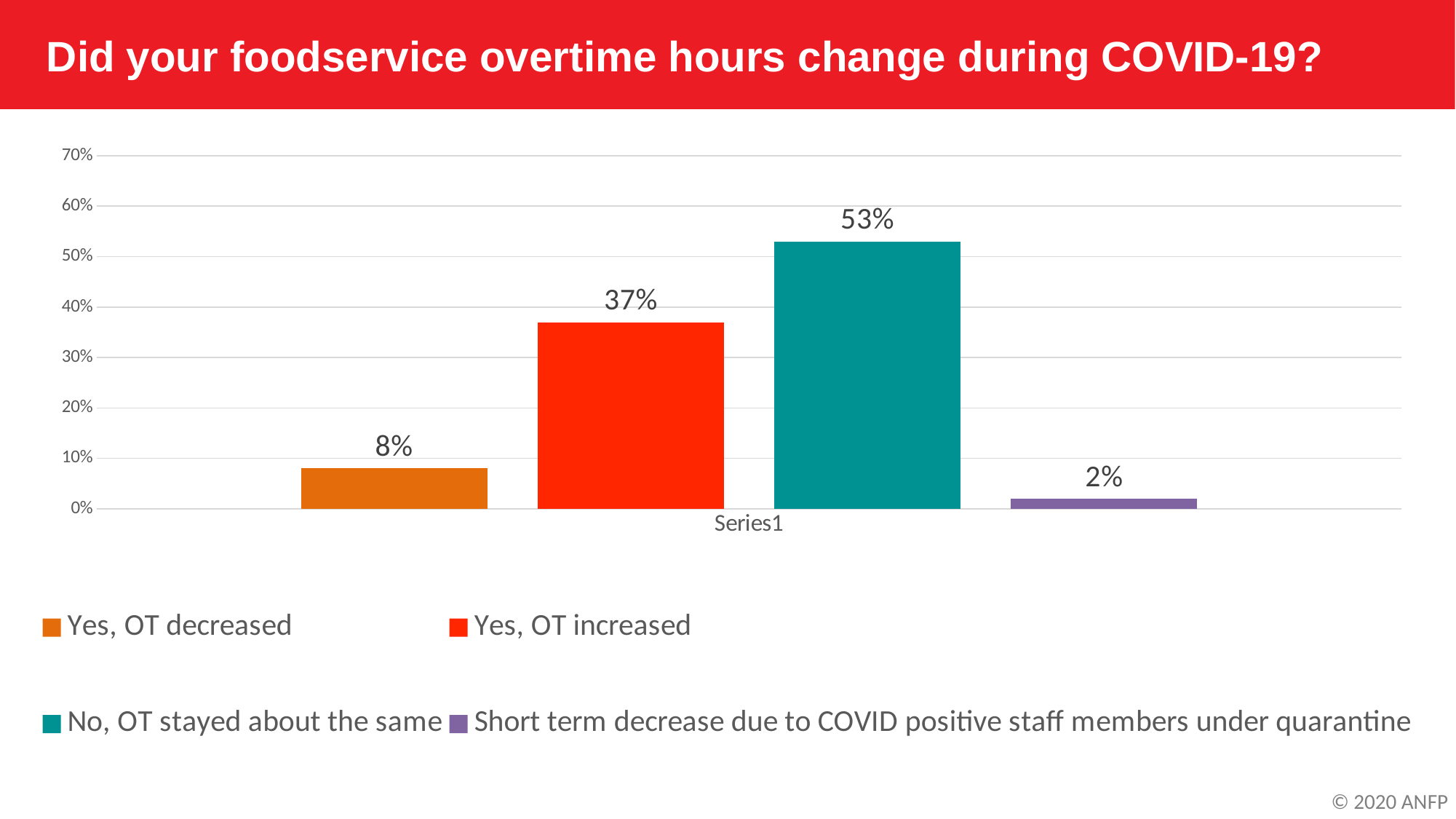
What colour is the bar for 'No, OT stayed about the same'? Teal Which response has the lowest percentage? Short term decrease due to COVID positive staff members under quarantine What percentage of respondents said OT stayed about the same? 53% What kind of chart is shown on the slide? Bar chart What percentage of respondents said OT increased? 37% What percentage of respondents reported a short term decrease due to COVID positive staff members under quarantine? 2% What percentage of respondents said OT decreased? 8% What is the difference in percentage points between 'No, OT stayed about the same' and 'Yes, OT increased'? 16 Which is larger: the percentage for 'Yes, OT increased' or 'Yes, OT decreased'? Yes, OT increased Which response has the highest percentage? No, OT stayed about the same What is the difference in percentage points between 'Yes, OT decreased' and the short term decrease response? 6 How many series does the legend list? 4